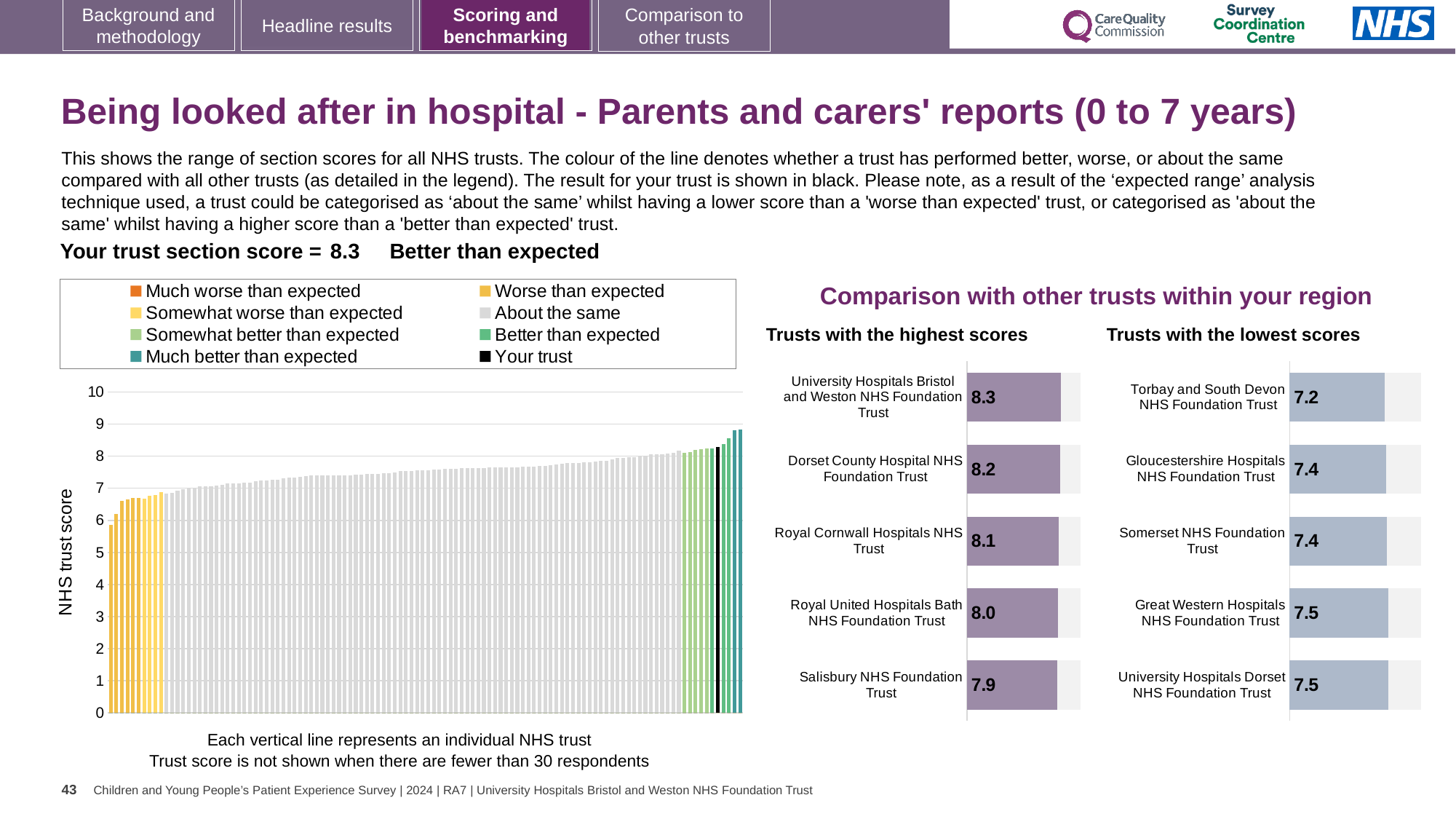
In the 'Trusts with the highest scores' chart, how many trusts are listed? 5 In the 'Trusts with the lowest scores' chart, what is the difference between the scores of University Hospitals Dorset NHS Foundation Trust and Torbay and South Devon NHS Foundation Trust? 0.3 How many entries does the legend of the large chart on the left list? 8 In the 'Trusts with the lowest scores' chart, which has the higher score: Gloucestershire Hospitals NHS Foundation Trust or Great Western Hospitals NHS Foundation Trust? Great Western Hospitals NHS Foundation Trust In the 'Trusts with the highest scores' chart, what is the difference between the scores of University Hospitals Bristol and Weston NHS Foundation Trust and Salisbury NHS Foundation Trust? 0.4 What kind of chart is the large chart on the left showing NHS trust scores? Bar chart In the 'Trusts with the lowest scores' chart, which trust has the lowest score? Torbay and South Devon NHS Foundation Trust In the large chart on the left, do the bar values rise or fall from left to right? Rise In the 'Trusts with the lowest scores' chart, what is the score for Torbay and South Devon NHS Foundation Trust? 7.2 In the large chart on the left, is the value of the black bar (your trust) greater or less than 8? greater In the 'Trusts with the highest scores' chart, what is the score for Dorset County Hospital NHS Foundation Trust? 8.2 In the 'Trusts with the highest scores' chart, which trust has the highest score? University Hospitals Bristol and Weston NHS Foundation Trust